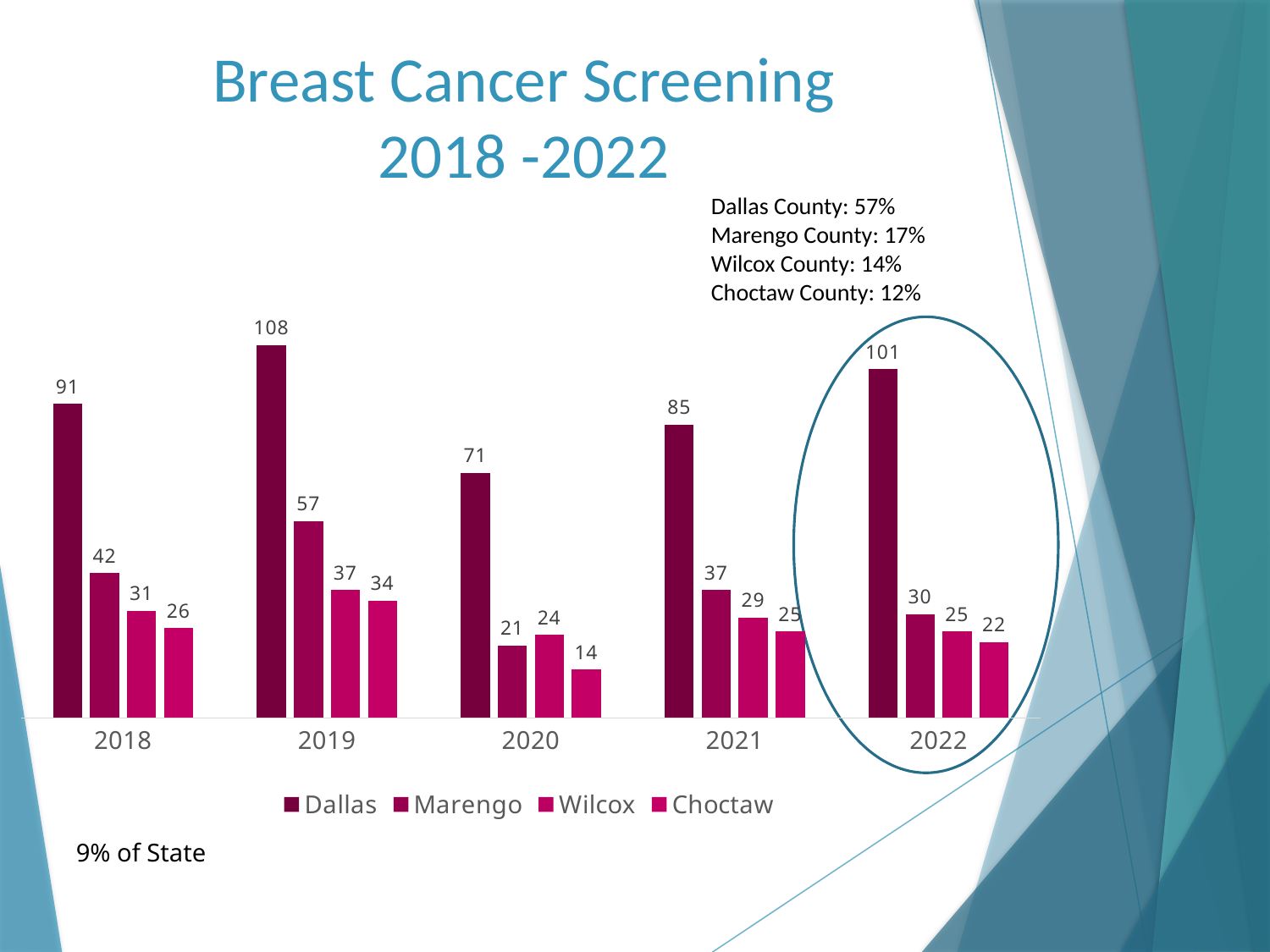
What is the value for Marengo in 2021? 37 In which year is the Dallas value highest? 2019 What is the value for Choctaw in 2020? 14 How many series does the legend list? 4 What is the difference between the Dallas values in 2019 and 2020? 37 How many years are shown on the x axis? 5 What kind of chart is shown on the slide? Bar chart What is the value for Dallas in 2019? 108 Which is larger, the Wilcox value in 2019 or the Wilcox value in 2022? Wilcox in 2019 What is the title of the chart? Breast Cancer Screening 2018 -2022 What is the total of the four county values in 2022? 178 In which year is the Marengo value lowest? 2020